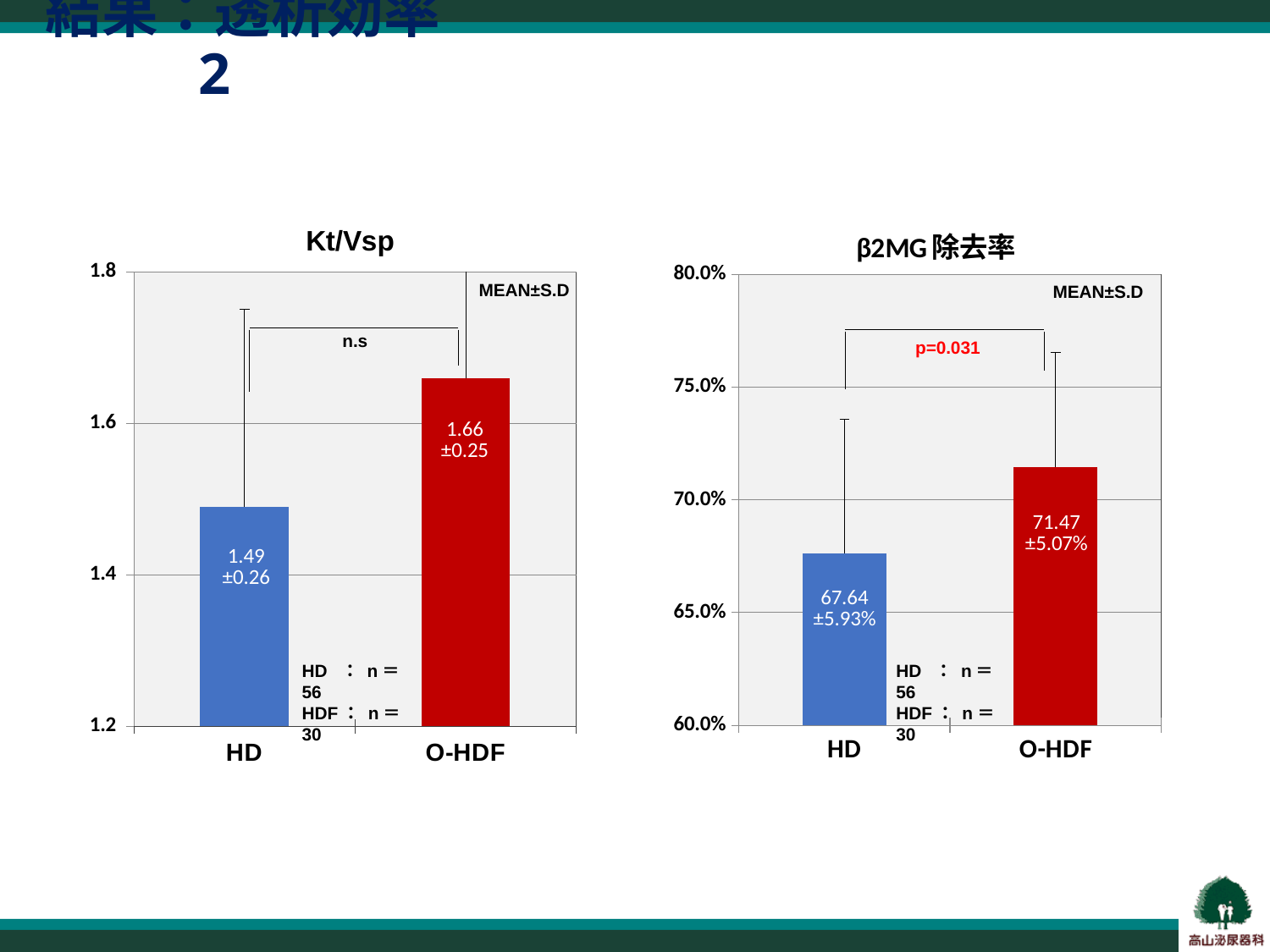
In the Kt/Vsp chart, what is the mean value for HD? 1.49 In the β2MG 除去率 chart, what p-value is shown between HD and O-HDF? p=0.031 In the β2MG 除去率 chart, which category has the lower mean value? HD What kind of chart is the β2MG 除去率 chart? bar chart In the β2MG 除去率 chart, what is the mean value for O-HDF? 71.47 In the Kt/Vsp chart, what is the mean value for O-HDF? 1.66 In the Kt/Vsp chart, which category has the higher mean value? O-HDF In the β2MG 除去率 chart, what is the difference between the mean values for O-HDF and HD? 3.83 In the Kt/Vsp chart, what is the difference between the mean values for O-HDF and HD? 0.17 In the β2MG 除去率 chart, what is the mean value for HD? 67.64 In the β2MG 除去率 chart, is the mean value for HD greater or less than 70.0%? less In the Kt/Vsp chart, how many categories are plotted? 2